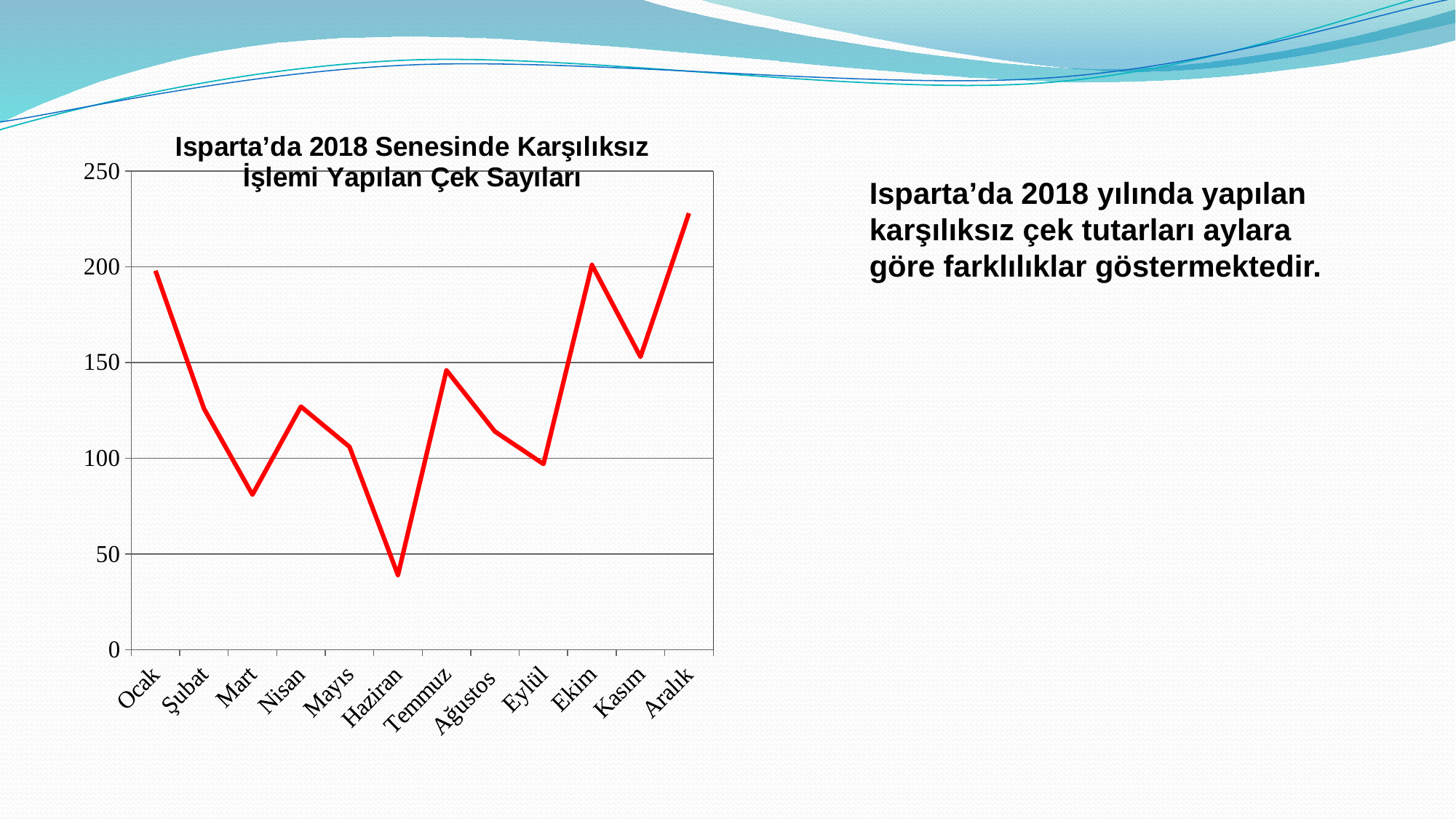
Which month has the highest value in the chart? Aralık Is the value for Ocak greater or less than 150? greater What is the title of the chart? Isparta’da 2018 Senesinde Karşılıksız İşlemi Yapılan Çek Sayıları Is the value for Mart greater or less than 100? less What kind of chart is shown on the slide? line chart Does the value rise or fall from Ocak to Mart? falls How many months are plotted on the x axis of the chart? 12 Is the value for Haziran greater or less than 50? less Which month has the lowest value in the chart? Haziran Which is larger, the value for Ocak or the value for Şubat? Ocak Which is larger, the value for Haziran or the value for Temmuz? Temmuz